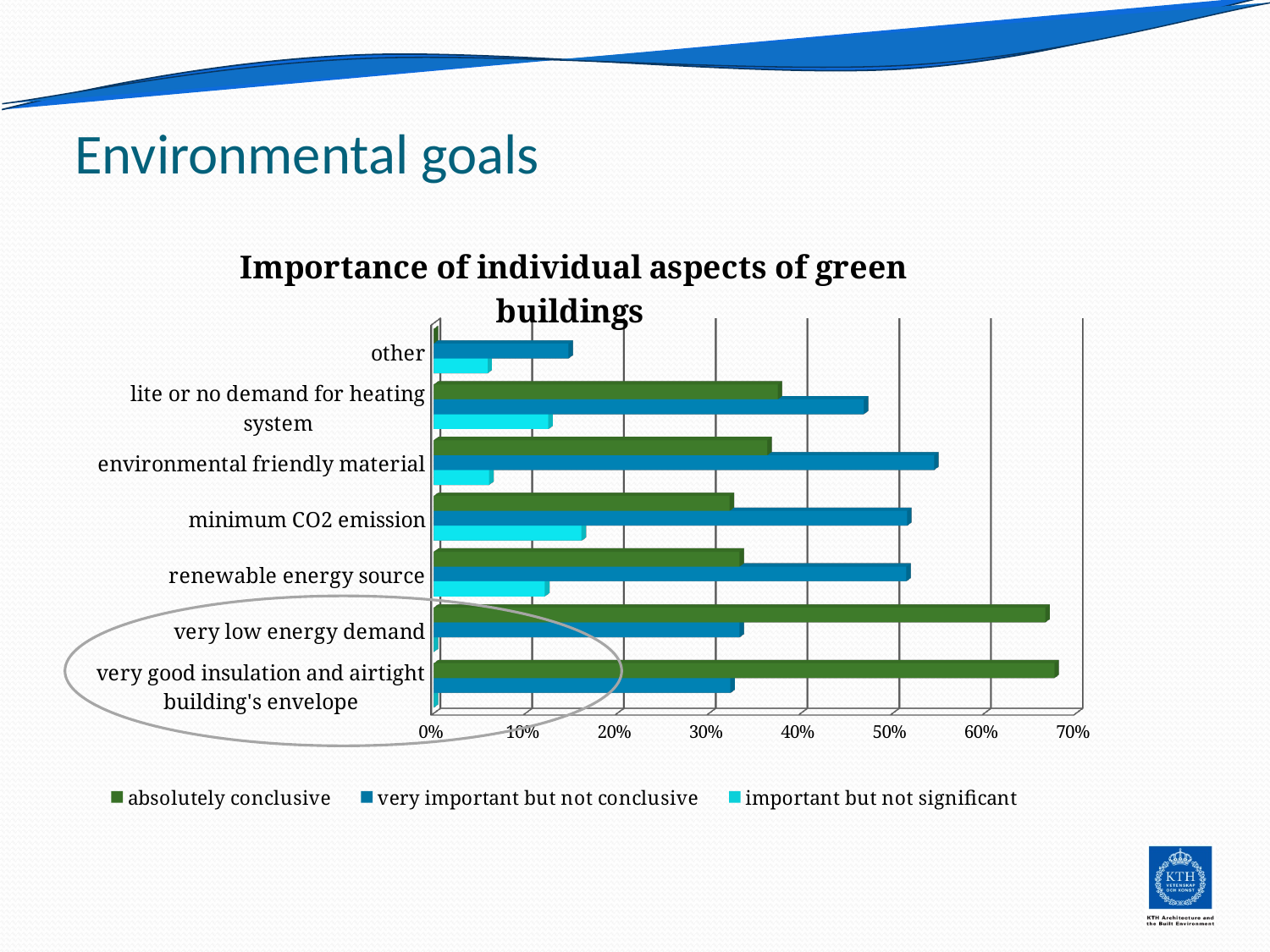
Is the 'very important but not conclusive' value for 'other' greater or less than 20%? less Is the 'absolutely conclusive' value for 'very low energy demand' greater or less than 60%? greater Which series is shown in green on the chart? absolutely conclusive How many series does the legend list? 3 Which is larger for 'environmental friendly material': the 'very important but not conclusive' value or the 'important but not significant' value? very important but not conclusive What kind of chart is shown on the slide? bar chart Which category has the highest value for the 'very important but not conclusive' series? environmental friendly material Which category has the lowest value for the 'absolutely conclusive' series? other Is the 'important but not significant' value for 'minimum CO2 emission' greater or less than 10%? greater How many categories are shown on the chart? 7 What is the title of the chart? Importance of individual aspects of green buildings Which is larger: the 'absolutely conclusive' value for 'very low energy demand' or for 'renewable energy source'? very low energy demand